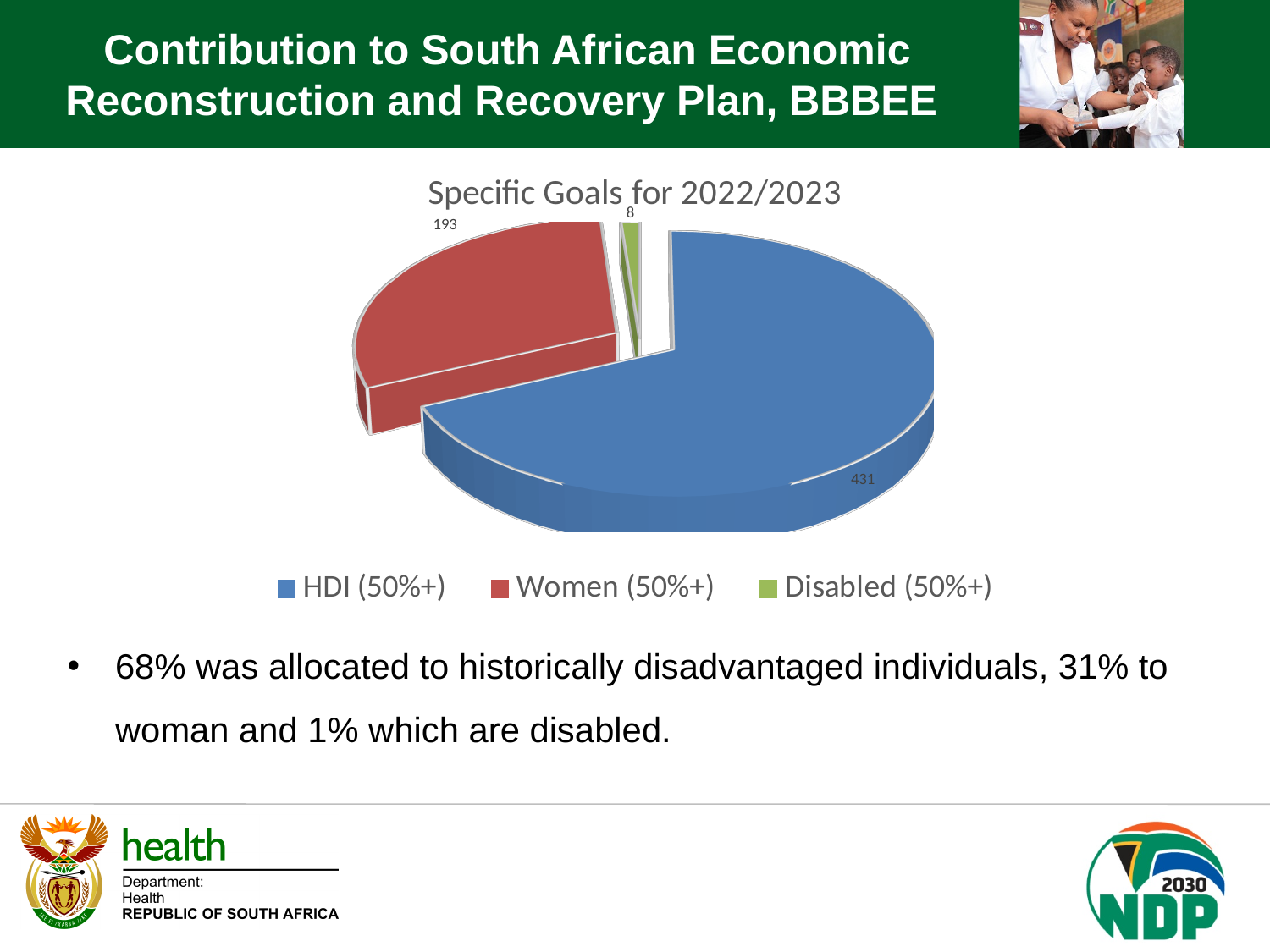
What type of chart is shown on the slide? Pie chart What is the difference between the values for Women (50%+) and Disabled (50%+)? 185 How many categories does the legend of the pie chart list? 3 What share of the pie is allocated to historically disadvantaged individuals (HDI)? 68% What is the value for Women (50%+) in the pie chart? 193 Which category has the largest slice of the pie? HDI (50%+) Which is larger, the value for Women (50%+) or the value for Disabled (50%+)? Women (50%+) Which category has the smallest slice of the pie? Disabled (50%+) What is the value for HDI (50%+) in the pie chart? 431 What is the value for Disabled (50%+) in the pie chart? 8 What is the title of the chart? Specific Goals for 2022/2023 What is the difference between the values for HDI (50%+) and Women (50%+)? 238